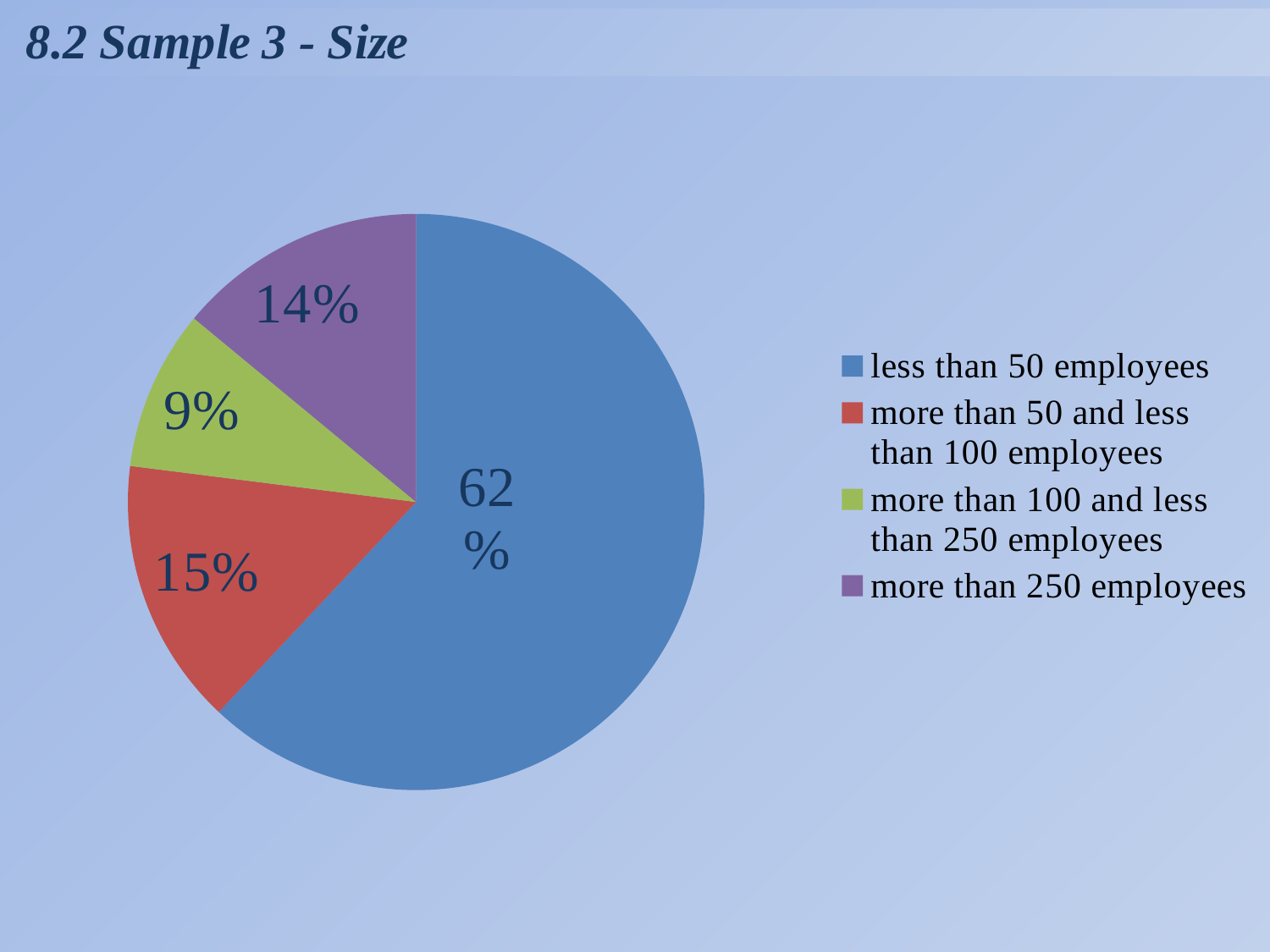
What is the difference in percentage points between the less than 50 employees slice and the more than 250 employees slice? 48 What share of the pie is for more than 50 and less than 100 employees? 15% Which is larger: the slice for more than 50 and less than 100 employees or the slice for more than 250 employees? more than 50 and less than 100 employees What share of the pie is for more than 100 and less than 250 employees? 9% Which category has the smallest slice of the pie? more than 100 and less than 250 employees Which category has the largest slice of the pie? less than 50 employees How many categories does the pie chart show? 4 What is the title of the slide containing the chart? 8.2 Sample 3 - Size What colour is the slice for more than 250 employees? purple What share of the pie is for less than 50 employees? 62% What kind of chart is shown on the slide? pie chart